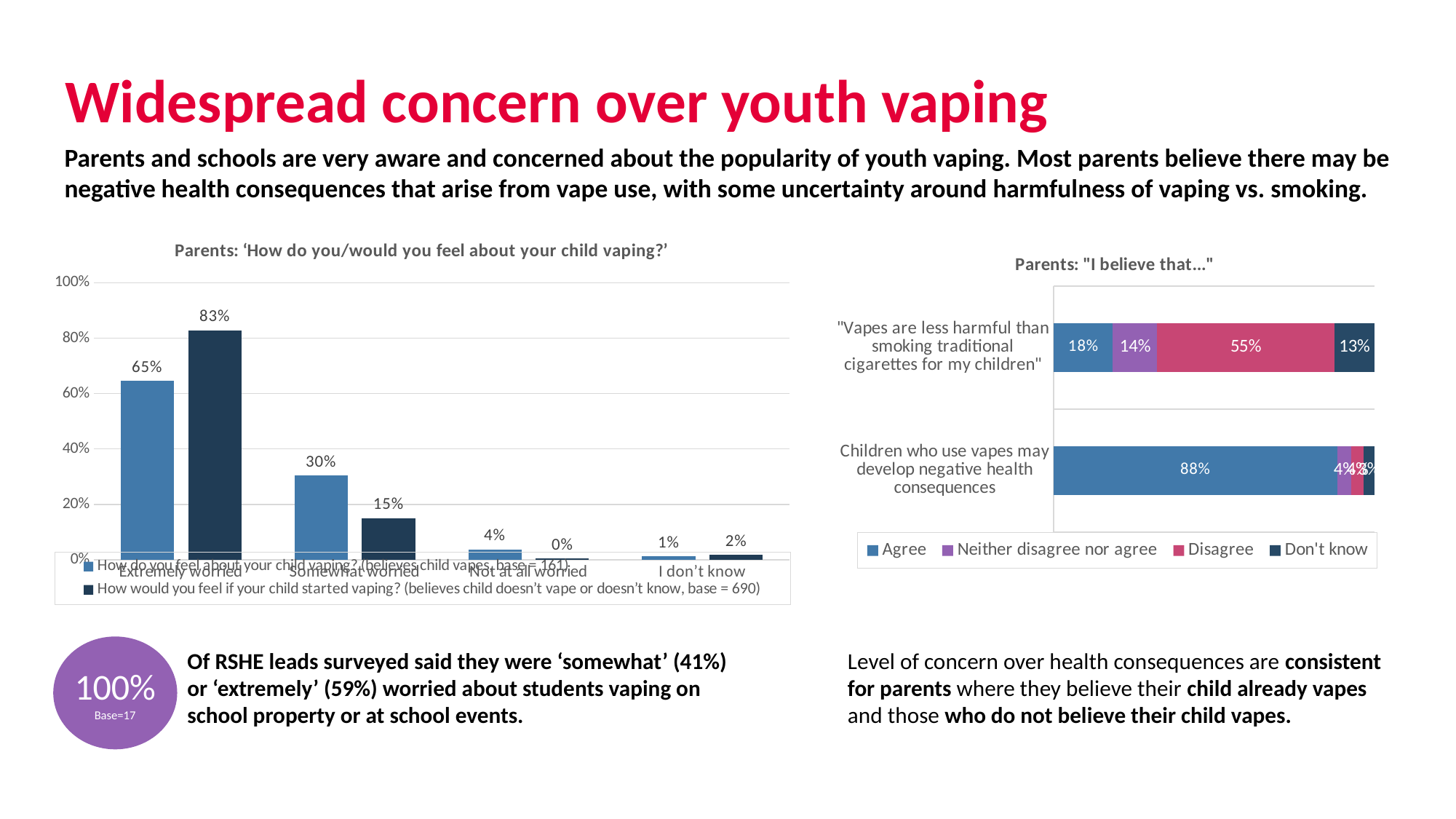
In the chart 'Parents: How do you/would you feel about your child vaping?', what is the value for 'Somewhat worried' among parents who believe their child vapes? 30% In the chart 'Parents: How do you/would you feel about your child vaping?', what percentage of parents who believe their child doesn't vape or don't know said they would be 'Extremely worried'? 83% In the chart 'Parents: I believe that...', what percentage of parents disagree that 'Vapes are less harmful than smoking traditional cigarettes for my children'? 55% In the chart 'Parents: How do you/would you feel about your child vaping?', what percentage of parents who believe their child vapes said they were 'Extremely worried'? 65% How many series does the legend list in the chart 'Parents: How do you/would you feel about your child vaping?'? 2 How many series does the legend list in the chart 'Parents: I believe that...'? 4 In the chart 'Parents: How do you/would you feel about your child vaping?', which category has the highest value for parents who believe their child doesn't vape or don't know? Extremely worried In the chart 'Parents: How do you/would you feel about your child vaping?', what is the difference in percentage points between the two series for 'Extremely worried'? 18 percentage points In the chart 'Parents: I believe that...', which statement has the larger 'Agree' share: 'Vapes are less harmful than smoking traditional cigarettes for my children' or 'Children who use vapes may develop negative health consequences'? Children who use vapes may develop negative health consequences What kind of chart is 'Parents: How do you/would you feel about your child vaping?'? Bar chart How many response categories are shown on the x axis of the chart 'Parents: How do you/would you feel about your child vaping?'? 4 In the chart 'Parents: I believe that...', what percentage of parents agree that 'Children who use vapes may develop negative health consequences'? 88%